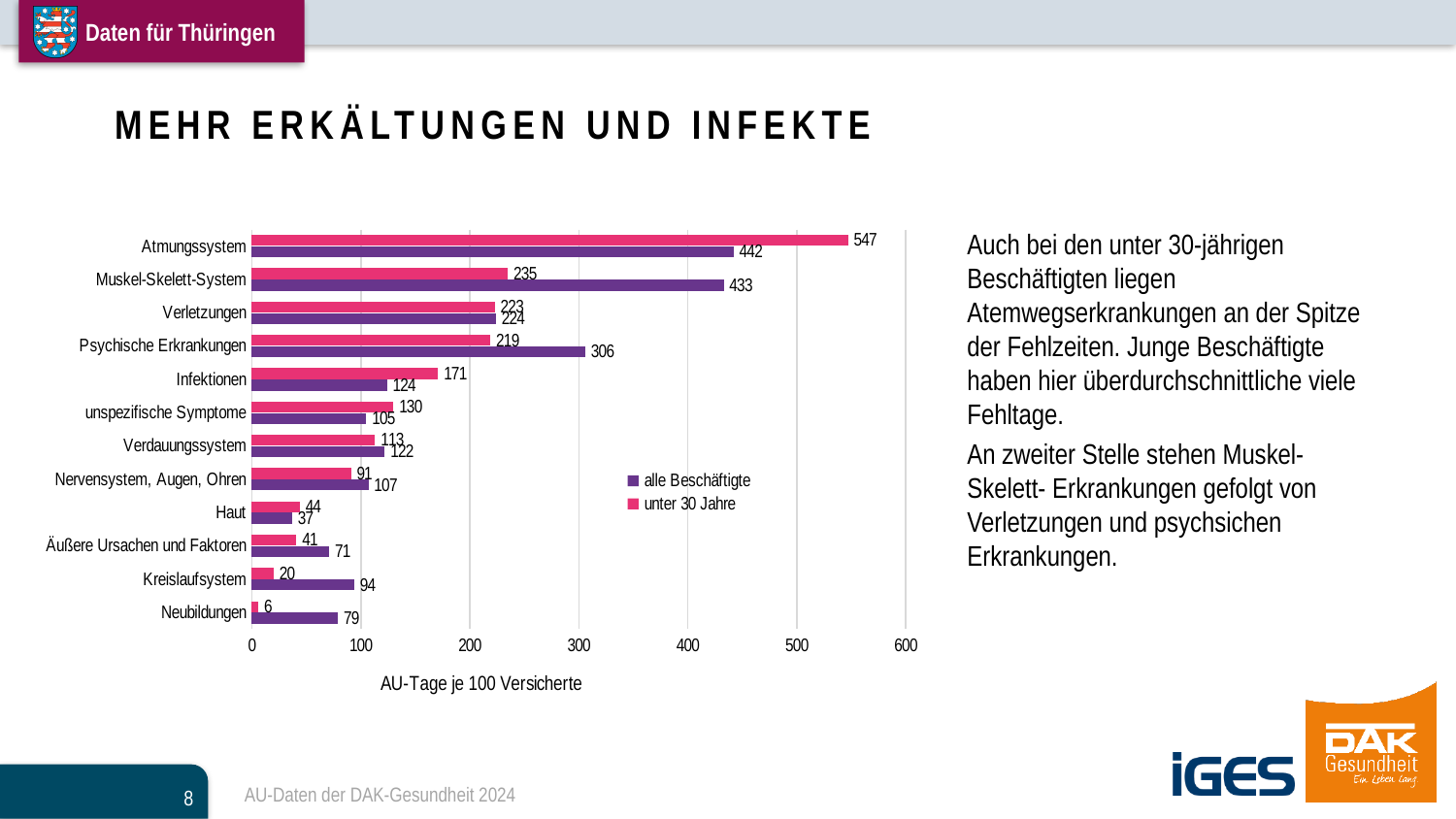
How many series does the legend list? 2 Which category has the lowest value in the 'unter 30 Jahre' series? Neubildungen What is the difference between the 'alle Beschäftigte' and 'unter 30 Jahre' values for Psychische Erkrankungen? 87 What is the value for Atmungssystem in the 'unter 30 Jahre' series? 547 What is the value for Kreislaufsystem in the 'unter 30 Jahre' series? 20 Is the 'alle Beschäftigte' value for Muskel-Skelett-System greater or less than 400? greater How many categories are shown on the chart? 12 What is the difference between the 'unter 30 Jahre' and 'alle Beschäftigte' values for Atmungssystem? 105 Which category has the highest value in the 'alle Beschäftigte' series? Atmungssystem What is the value for Muskel-Skelett-System in the 'alle Beschäftigte' series? 433 For Infektionen, which series has the larger value: 'alle Beschäftigte' or 'unter 30 Jahre'? unter 30 Jahre What kind of chart is shown on the slide? bar chart